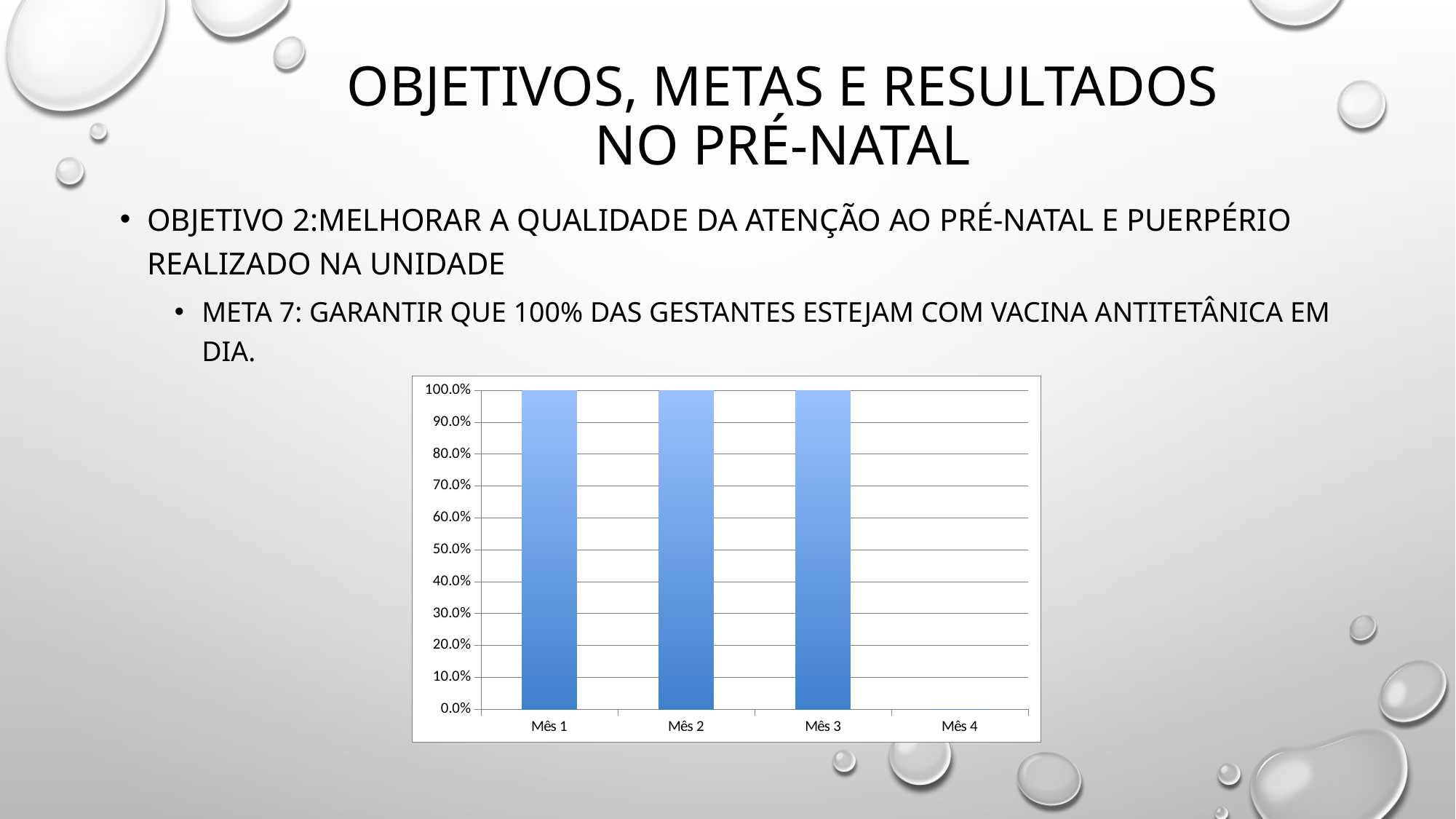
What is the difference between the value for Mês 1 and the value for Mês 4? 100.0% What is the value for Mês 4? 0.0% What is the highest tick shown on the vertical axis? 100.0% What is the value for Mês 3? 100.0% What is the value for Mês 1? 100.0% Is the value for Mês 4 greater or less than 10.0%? less Which category has the lowest value? Mês 4 How many categories are shown on the x axis? 4 What colour are the bars in the chart? Blue Which is larger, the value for Mês 3 or the value for Mês 4? Mês 3 Is the value for Mês 2 greater or less than 50.0%? greater What kind of chart is shown on the slide? Bar chart